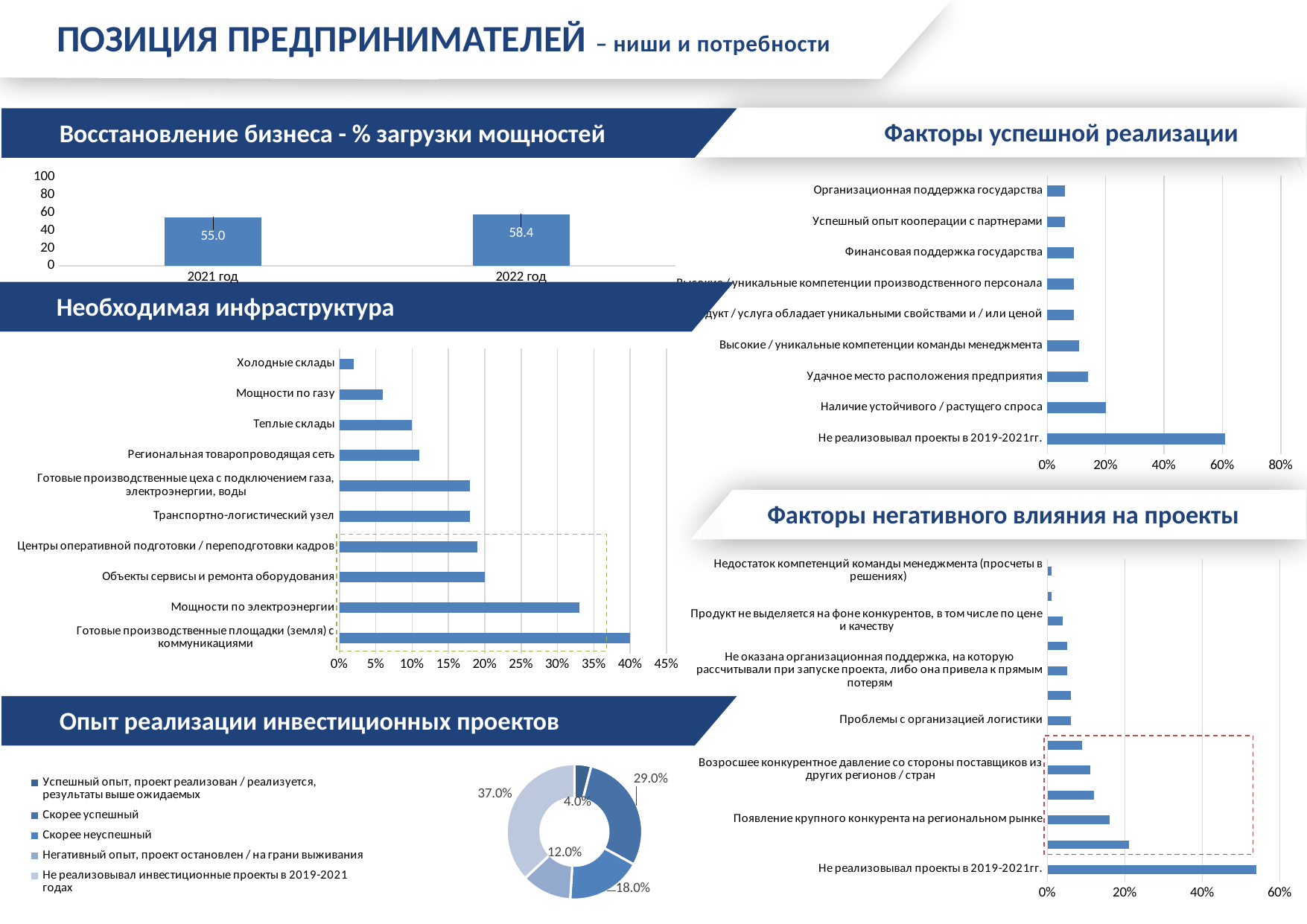
What type of chart is used in 'Опыт реализации инвестиционных проектов'? Doughnut chart In the chart 'Восстановление бизнеса - % загрузки мощностей', what is the difference between the 2022 год and 2021 год values? 3.4 How many categories are shown in the chart 'Необходимая инфраструктура'? 10 In the chart 'Восстановление бизнеса - % загрузки мощностей', what is the value for 2022 год? 58.4 In the chart 'Факторы негативного влияния на проекты', is the value for 'Не реализовывал проекты в 2019-2021гг.' greater or less than 40%? greater In the chart 'Опыт реализации инвестиционных проектов', what share is shown for 'Не реализовывал инвестиционные проекты в 2019-2021 годах'? 37.0% In the chart 'Необходимая инфраструктура', which category has the highest value? Готовые производственные площадки (земля) с коммуникациями In the chart 'Необходимая инфраструктура', is the value for 'Мощности по электроэнергии' greater or less than 30%? greater In the chart 'Восстановление бизнеса - % загрузки мощностей', which year has the higher value, 2021 год or 2022 год? 2022 год In the chart 'Необходимая инфраструктура', which category has the lowest value? Холодные склады In the chart 'Восстановление бизнеса - % загрузки мощностей', what is the value for 2021 год? 55.0 In the chart 'Факторы успешной реализации', which category has the highest value? Не реализовывал проекты в 2019-2021гг.